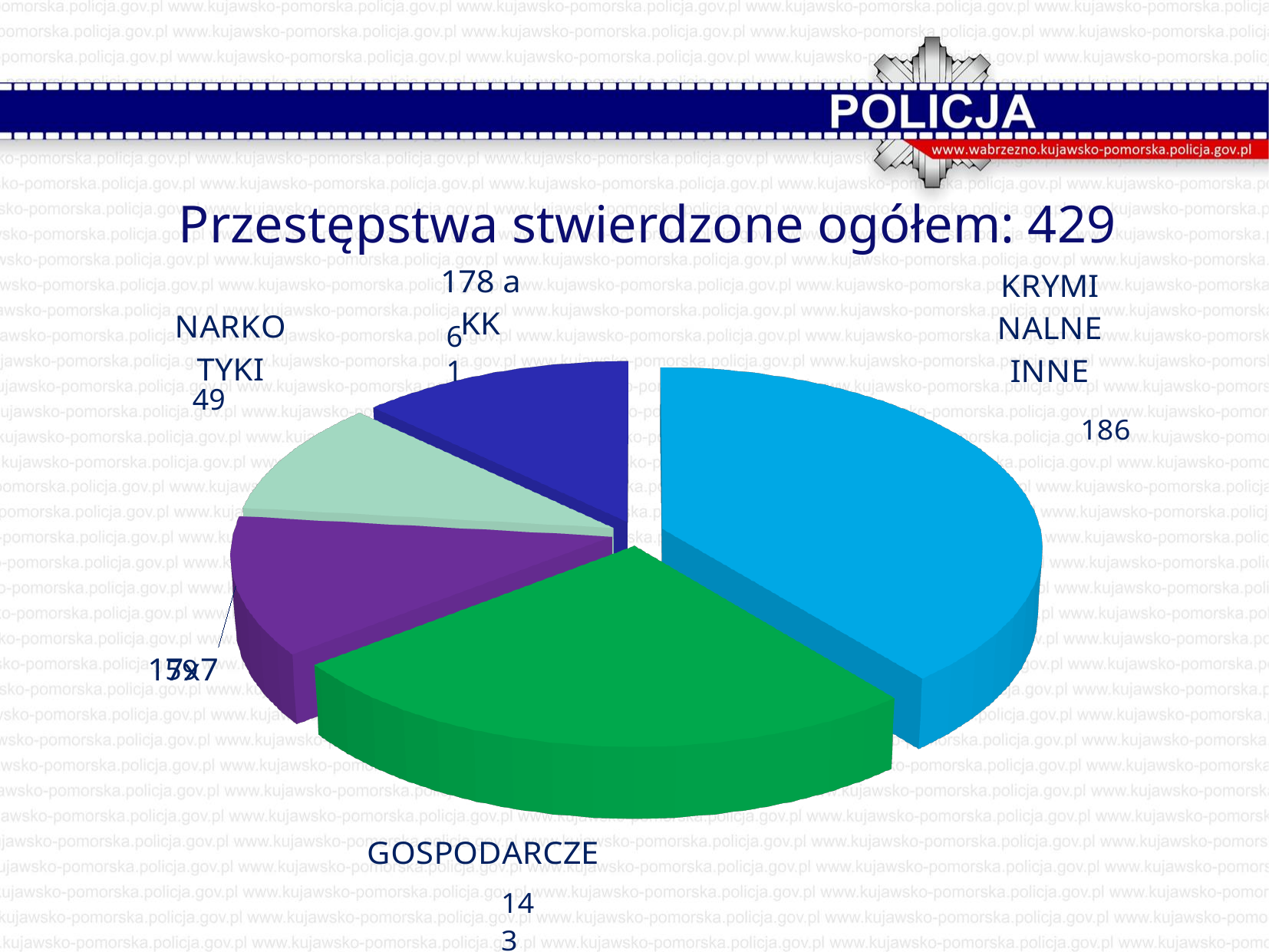
Which is larger, GOSPODARCZE or NARKOTYKI? GOSPODARCZE How many slices does the pie chart have? 5 What colour is the GOSPODARCZE slice? green What is the difference between the values for KRYMINALNE INNE and GOSPODARCZE? 43 Which is larger, KRYMINALNE INNE or GOSPODARCZE? KRYMINALNE INNE What is the difference between the values for KRYMINALNE INNE and NARKOTYKI? 137 What is the value for KRYMINALNE INNE? 186 What is the value for NARKOTYKI? 49 What type of chart is shown on the slide? pie chart What is the value for GOSPODARCZE? 143 What is the title of the chart on the slide? Przestępstwa stwierdzone ogółem: 429 Which category has the largest slice of the pie? KRYMINALNE INNE